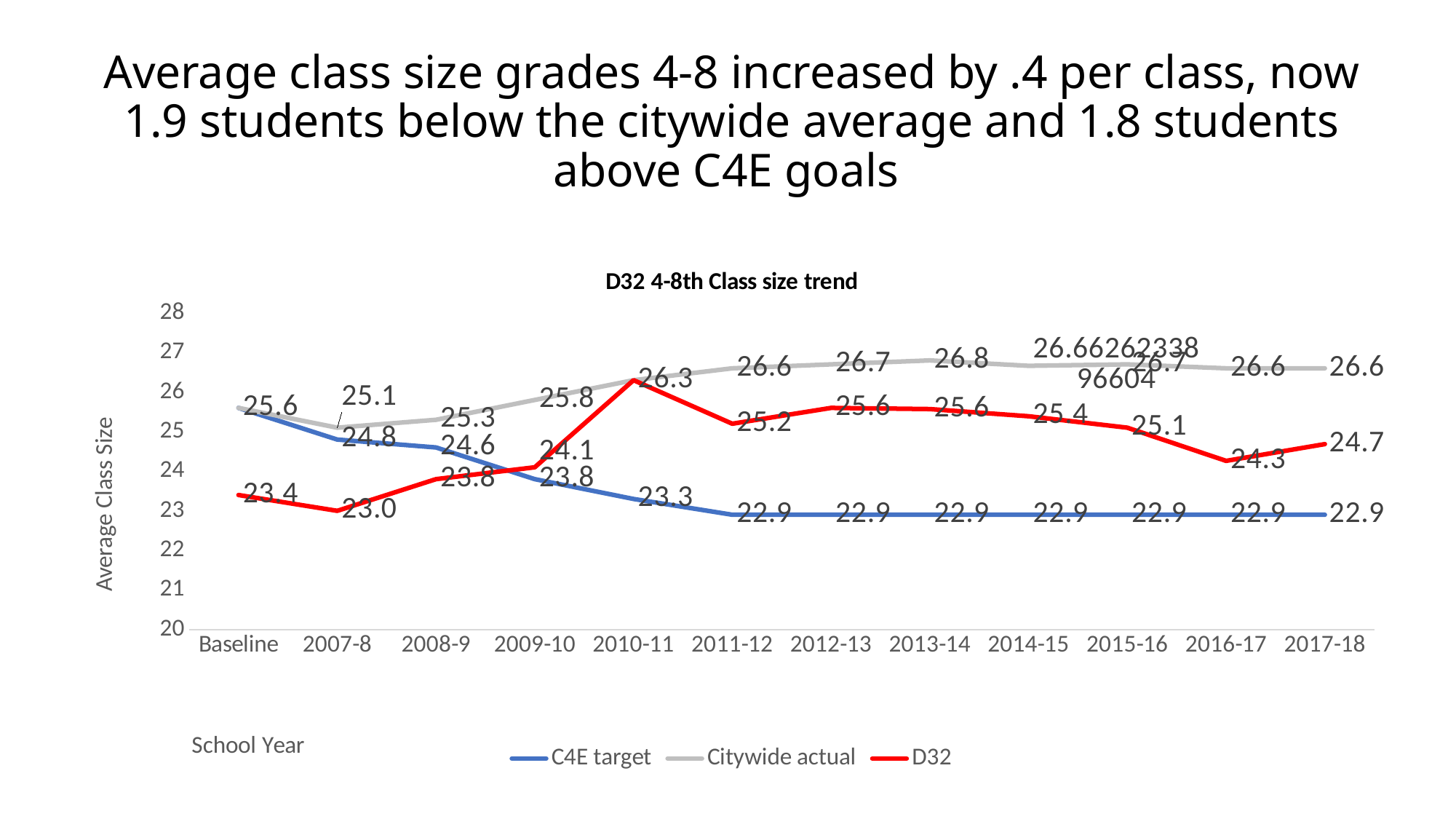
What is the difference between the D32 value and the C4E target value in 2017-18? 1.8 What is the Citywide actual value for 2013-14? 26.8 In 2016-17, which is larger: the D32 value or the C4E target value? D32 What kind of chart is shown? Line chart What is the C4E target value for 2017-18? 22.9 How many series does the legend list? 3 In which school year is the D32 line at its lowest? 2007-8 In which school year is the D32 line at its highest? 2010-11 What is the D32 value for 2017-18? 24.7 What is the D32 value for 2016-17? 24.3 How many school-year points are plotted along the x axis? 12 What is the difference between the Citywide actual value and the D32 value in 2017-18? 1.9